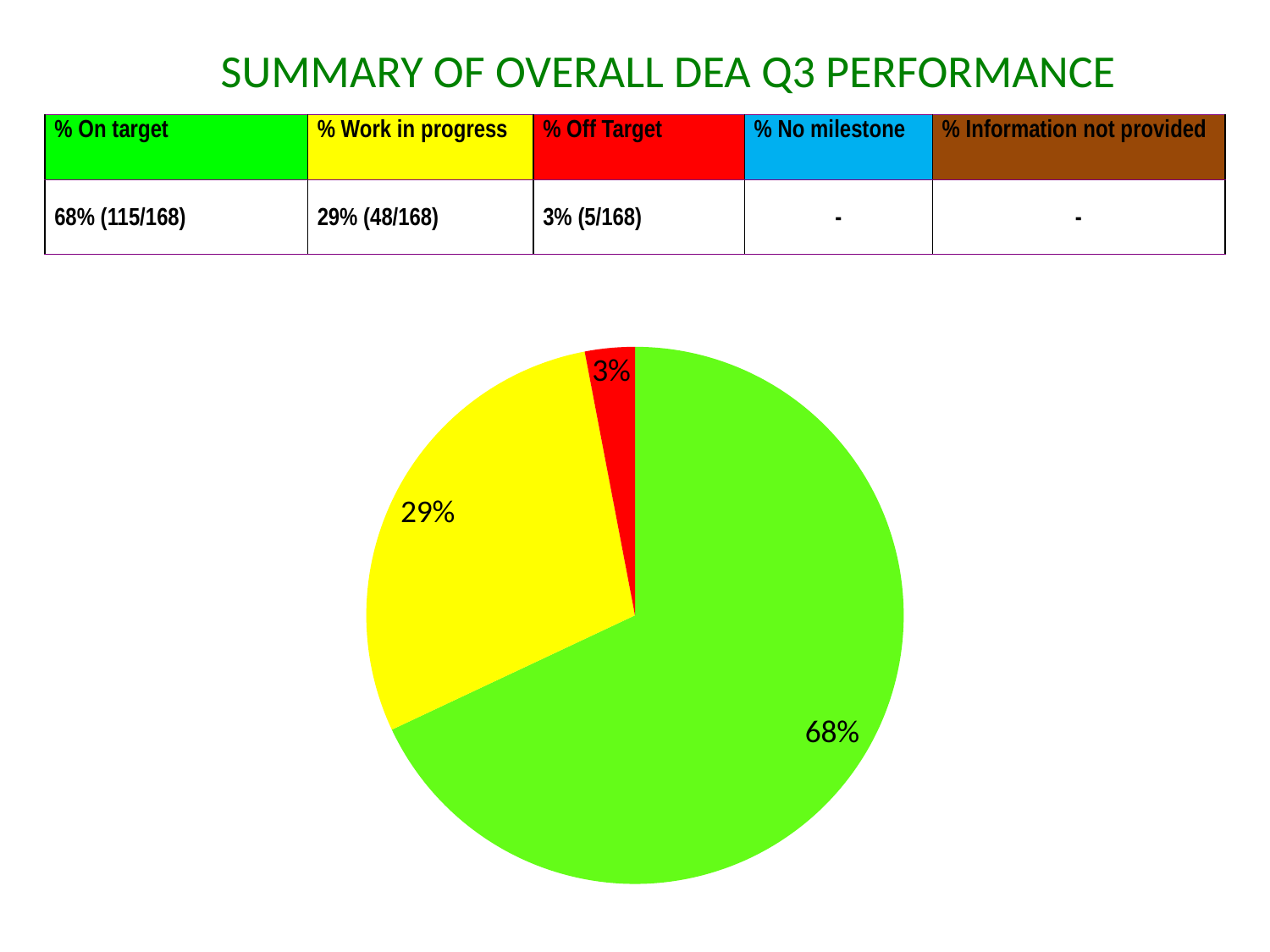
What share of the pie does the red slice represent? 3% Using the colour key in the table above the chart, which category does the green slice of the pie represent? % On target How many slices does the pie chart have? 3 Which slice of the pie chart is the smallest? the red slice (3%) What kind of chart is shown on the slide? pie chart What share of the pie does the green slice represent? 68% What share of the pie does the yellow slice represent? 29% What is the difference in percentage points between the yellow slice and the red slice? 26 Which slice of the pie chart is the largest? the green slice (68%) Which is larger in the pie chart, the yellow slice or the red slice? the yellow slice What is the difference in percentage points between the green slice and the yellow slice? 39 What colour is the slice labelled 3% in the pie chart? red